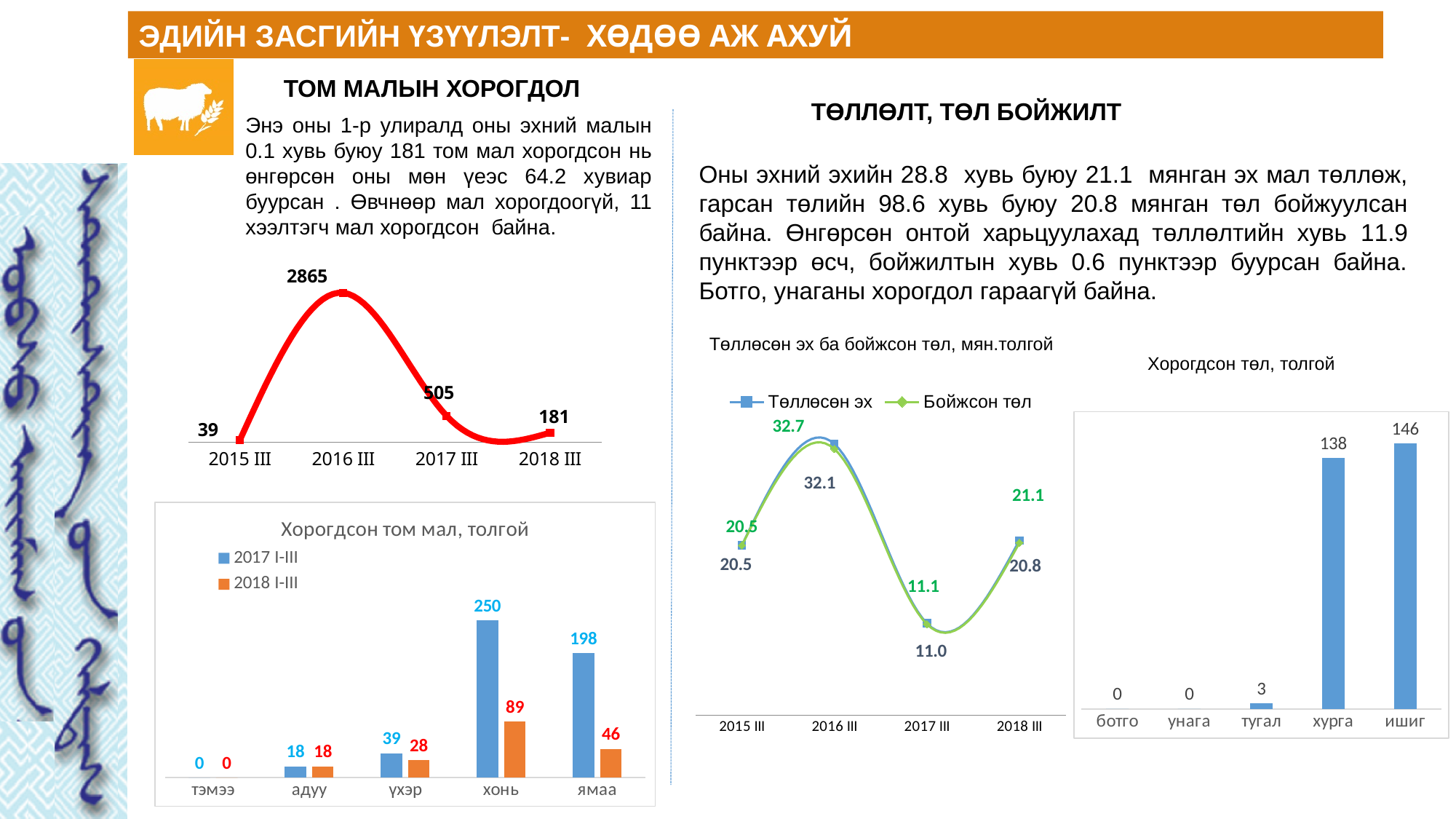
In the red line chart under 'ТОМ МАЛЫН ХОРОГДОЛ' on the left, what is the value for 2016 III? 2865 In the chart 'Хорогдсон том мал, толгой', what is the difference between the 2017 I-III and 2018 I-III values for ямаа? 152 What kind of chart is 'Хорогдсон төл, толгой'? bar chart In the chart 'Хорогдсон төл, толгой', how many categories are shown on the x axis? 5 In the red line chart under 'ТОМ МАЛЫН ХОРОГДОЛ' on the left, which period has the lowest value? 2015 III In the chart 'Хорогдсон том мал, толгой', what is the value for хонь in 2018 I-III? 89 In the chart 'Төллөсөн эх ба бойжсон төл, мян.толгой', how many series does the legend list? 2 In the chart 'Хорогдсон том мал, толгой', which category has the highest value for 2017 I-III? хонь In the chart 'Хорогдсон төл, толгой', what is the value for тугал? 3 In the red line chart under 'ТОМ МАЛЫН ХОРОГДОЛ' on the left, what is the difference between the 2017 III and 2018 III values? 324 In the chart 'Хорогдсон төл, толгой', which category has the highest value? ишиг In the chart 'Хорогдсон том мал, толгой', how many series does the legend list? 2